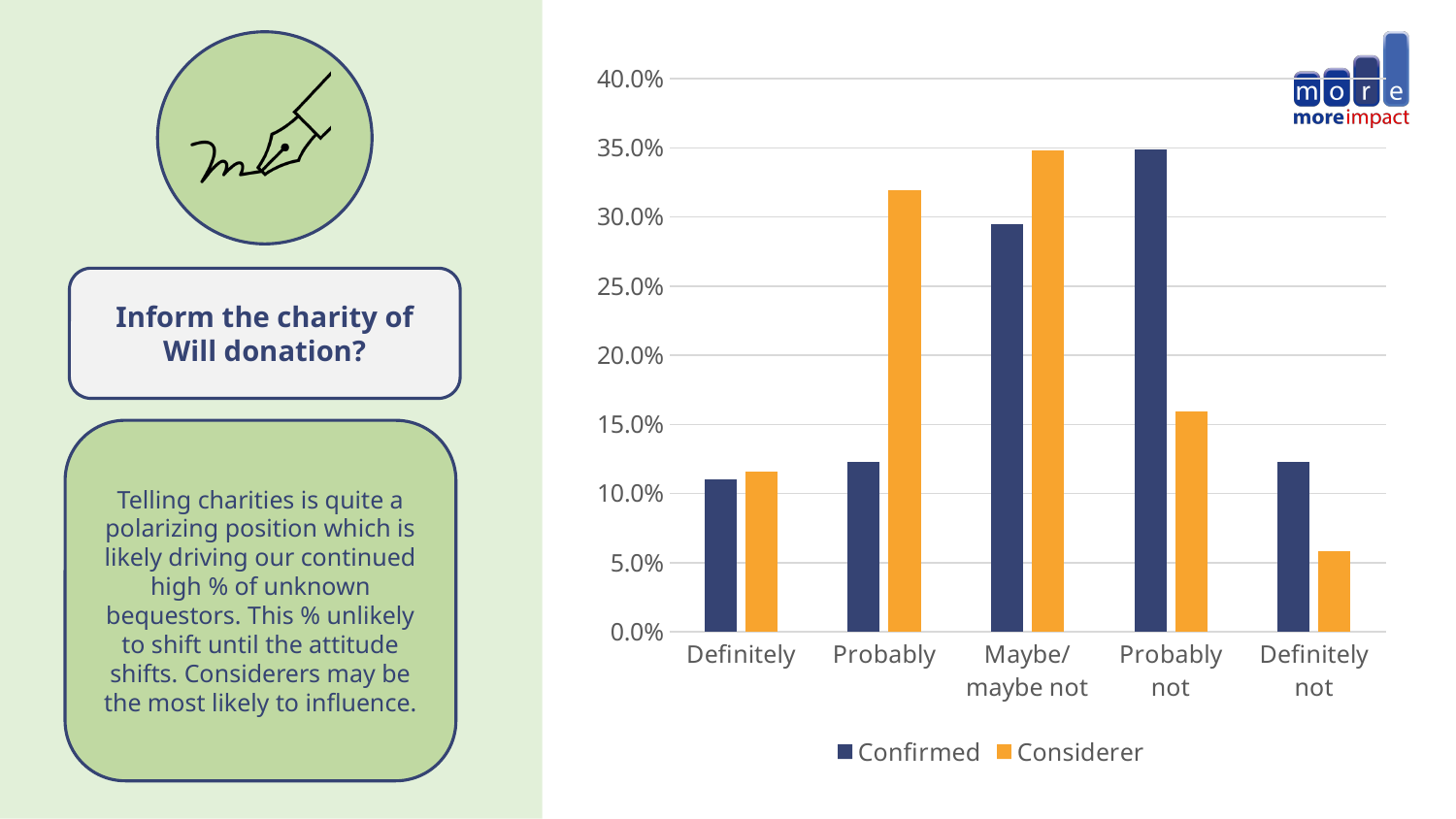
Is the Considerer value for Probably not greater or less than 20.0%? less What kind of chart is shown on the slide? Bar chart Is the Considerer value for Probably greater or less than 30.0%? greater For the Probably category, which series has the larger value, Confirmed or Considerer? Considerer How many series does the chart's legend list? 2 Which category has the highest value for the Considerer series? Maybe/maybe not How many categories are shown on the x axis of the chart? 5 Which colour represents the Considerer series in the chart? Orange Which category has the highest value for the Confirmed series? Probably not Is the Considerer value for Definitely not greater or less than 10.0%? less For the Probably not category, which series has the larger value, Confirmed or Considerer? Confirmed Which category has the lowest value for the Considerer series? Definitely not